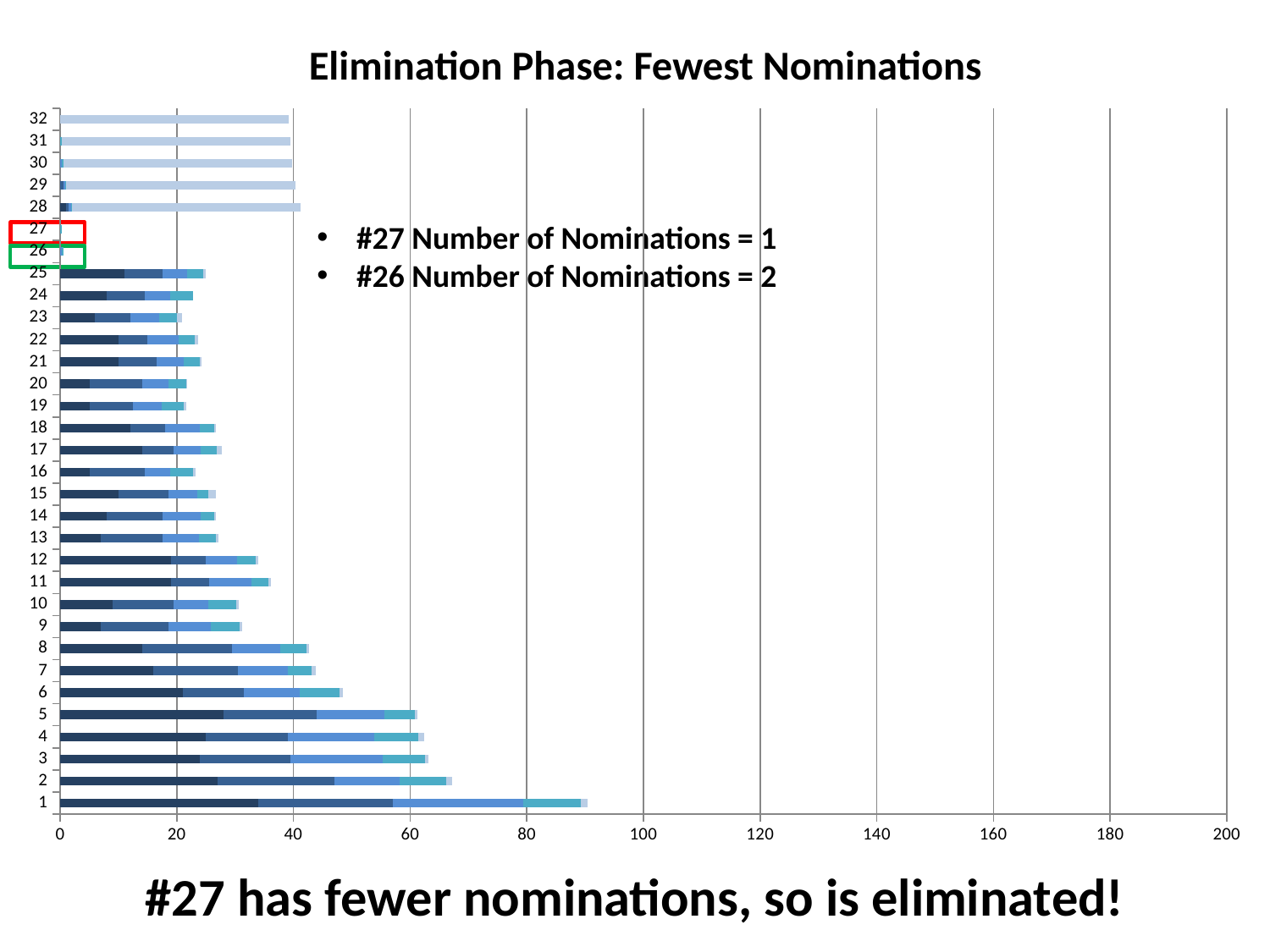
Which has a longer bar, category 6 or category 9? 6 Which has a longer bar, category 2 or category 12? 2 According to the slide, what is the number of nominations for #26? 2 How many categories are listed on the vertical axis of the chart? 32 Is the total bar length for category 12 greater or less than 40? less What kind of chart is shown on the slide? bar chart Is the total bar length for category 1 greater or less than 80? greater Is the total bar length for category 5 greater or less than 80? less What is the title of the slide above the chart? Elimination Phase: Fewest Nominations What is the difference between the number of nominations for #26 and #27? 1 According to the slide, what is the number of nominations for #27? 1 Which category has the longest bar in the chart? 1